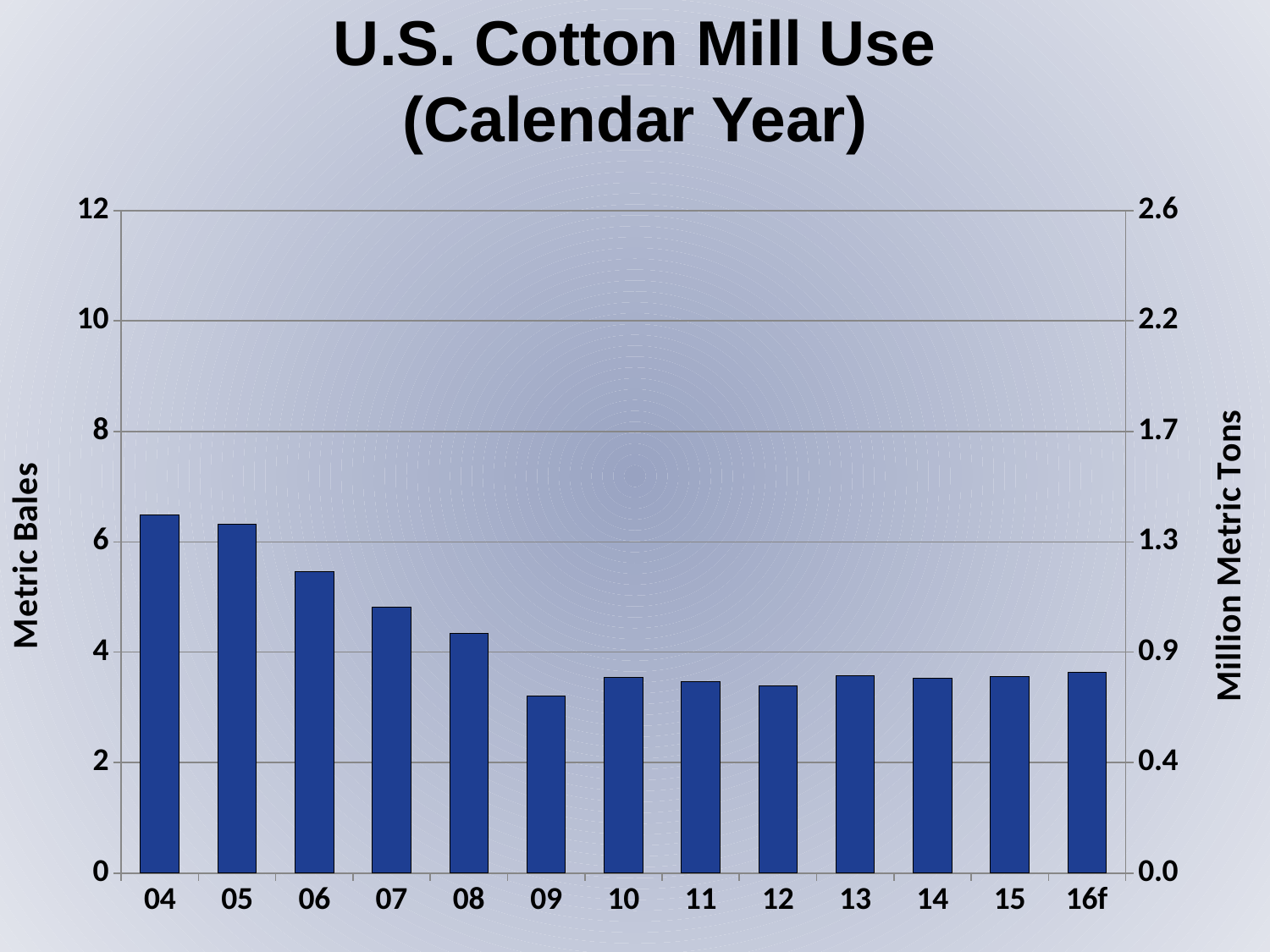
How many years (categories) are plotted on the x axis? 13 Which year has the lowest cotton mill use? 09 Is the value for 09 greater or less than 4 on the Metric Bales axis? less Is the value for 08 greater or less than 4 on the Metric Bales axis? greater Is the value for 06 greater or less than 6 on the Metric Bales axis? less What is the title of the chart? U.S. Cotton Mill Use (Calendar Year) Which year has the highest cotton mill use? 04 Do the values rise or fall from 04 to 09? fall Which is larger, the value for 06 or the value for 08? 06 What is the label of the right-hand vertical axis? Million Metric Tons What kind of chart is shown on the slide? bar chart